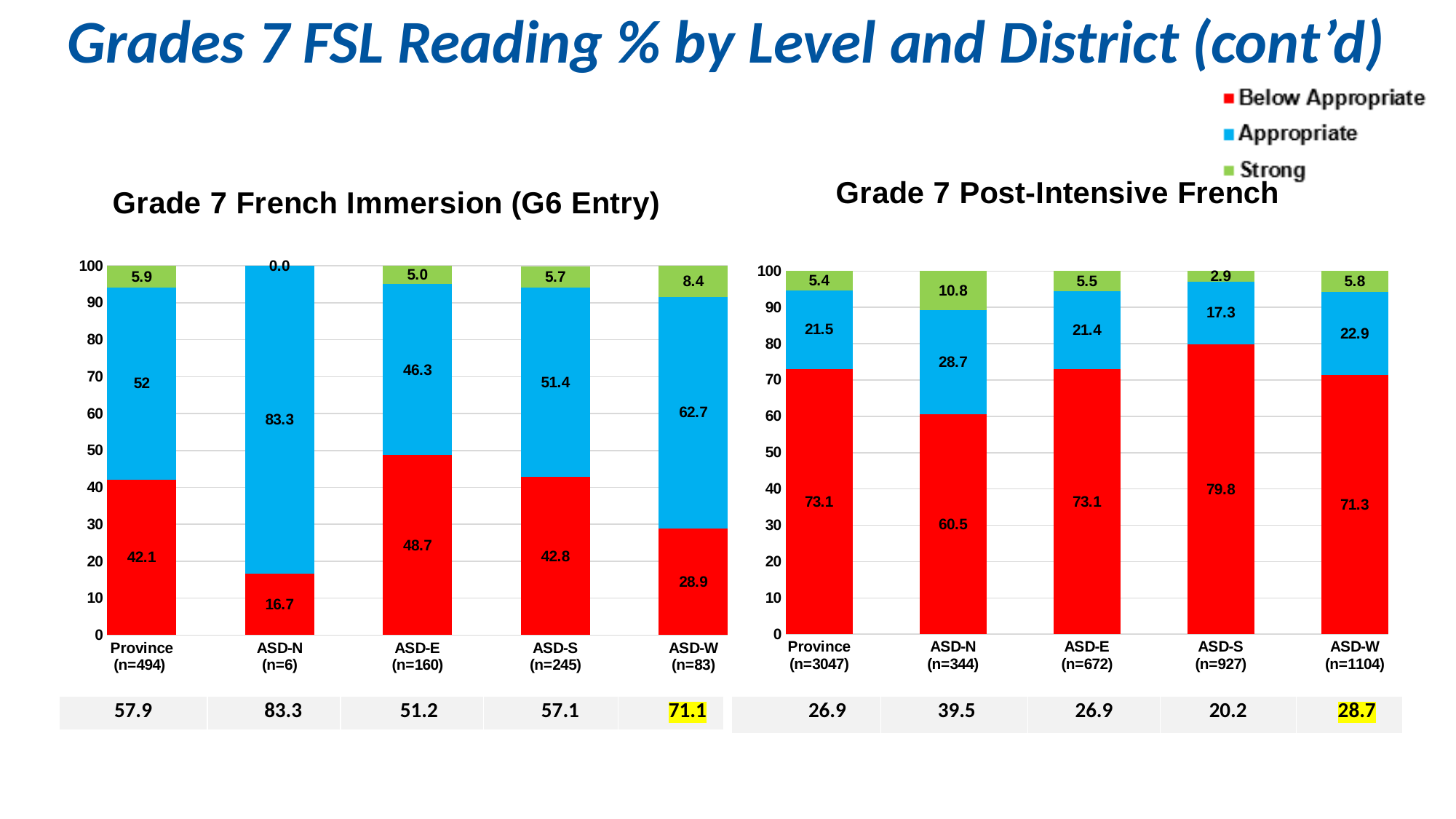
In the Grade 7 Post-Intensive French chart, what is the Appropriate value for ASD-W? 22.9 How many series does the legend list? 3 In the Grade 7 Post-Intensive French chart, which category has the lowest Strong value? ASD-S In the Grade 7 French Immersion (G6 Entry) chart, which district has the highest Appropriate value? ASD-N How many categories are shown on the x axis of the Grade 7 Post-Intensive French chart? 5 What kind of chart is the Grade 7 French Immersion (G6 Entry) chart? Stacked bar chart In the Grade 7 Post-Intensive French chart, what is the Strong value for ASD-N? 10.8 In the Grade 7 French Immersion (G6 Entry) chart, what is the Strong value for ASD-W? 8.4 In the Grade 7 French Immersion (G6 Entry) chart, what is the Below Appropriate value for ASD-E? 48.7 Which colour represents the Strong series in the legend? Green In the Grade 7 French Immersion (G6 Entry) chart, which is larger: the Below Appropriate value for Province or for ASD-W? Province In the Grade 7 Post-Intensive French chart, what is the difference between the Below Appropriate values for ASD-S and ASD-N? 19.3